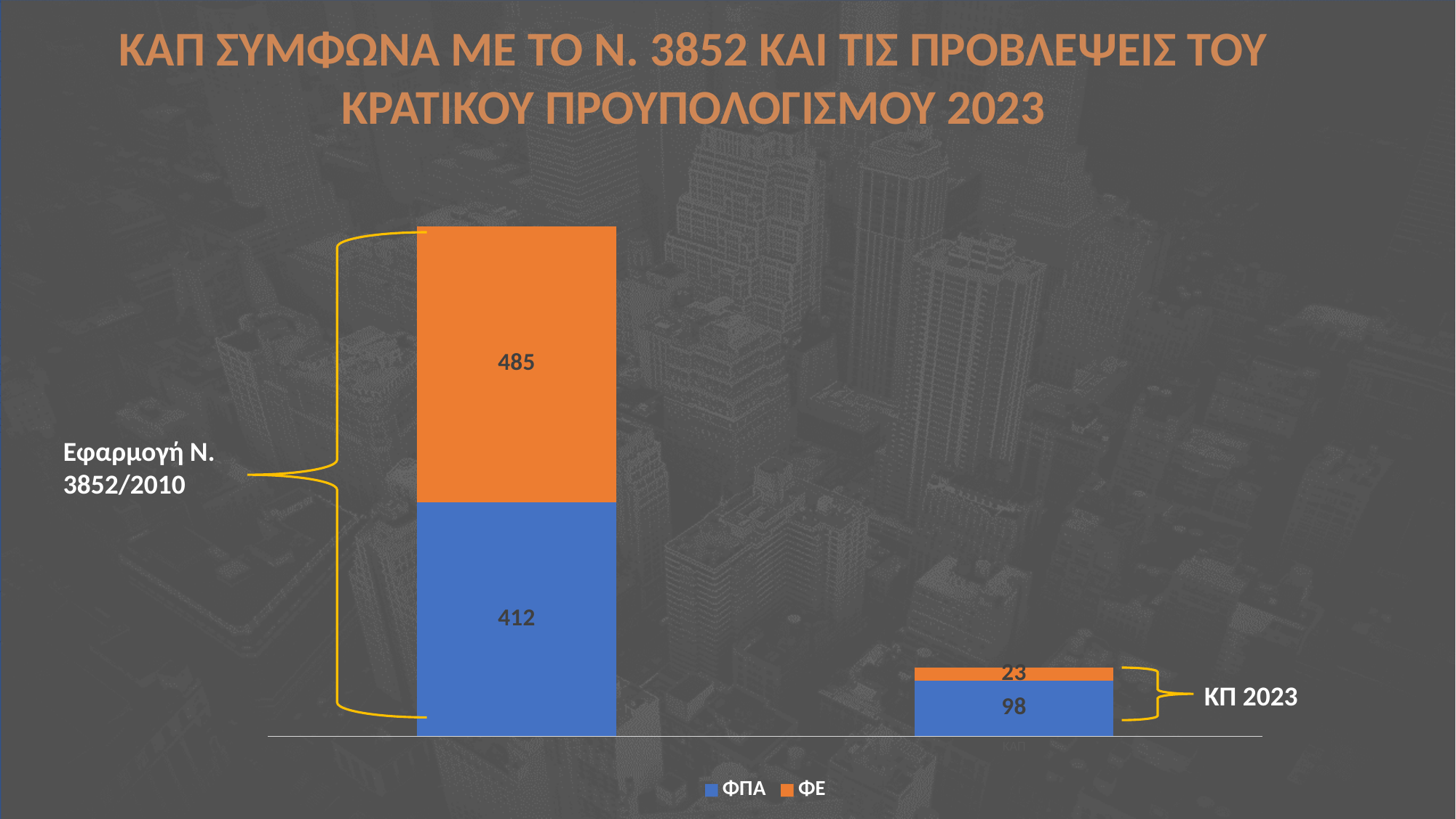
What is the total of the stacked bar labelled Εφαρμογή Ν. 3852/2010? 897 Which colour represents the ΦΕ series? orange What is the difference between the ΦΕ and ΦΠΑ values in the bar labelled Εφαρμογή Ν. 3852/2010? 73 What are the two series named in the legend? ΦΠΑ and ΦΕ What is the ΦΠΑ value for the bar labelled Εφαρμογή Ν. 3852/2010? 412 What is the ΦΕ value for the bar labelled Εφαρμογή Ν. 3852/2010? 485 Which is larger in the bar labelled ΚΠ 2023, ΦΠΑ or ΦΕ? ΦΠΑ What is the ΦΠΑ value for the bar labelled ΚΠ 2023? 98 How many series does the legend list? 2 What is the ΦΕ value for the bar labelled ΚΠ 2023? 23 What kind of chart is shown on the slide? stacked bar chart What is the total of the stacked bar labelled ΚΠ 2023? 121